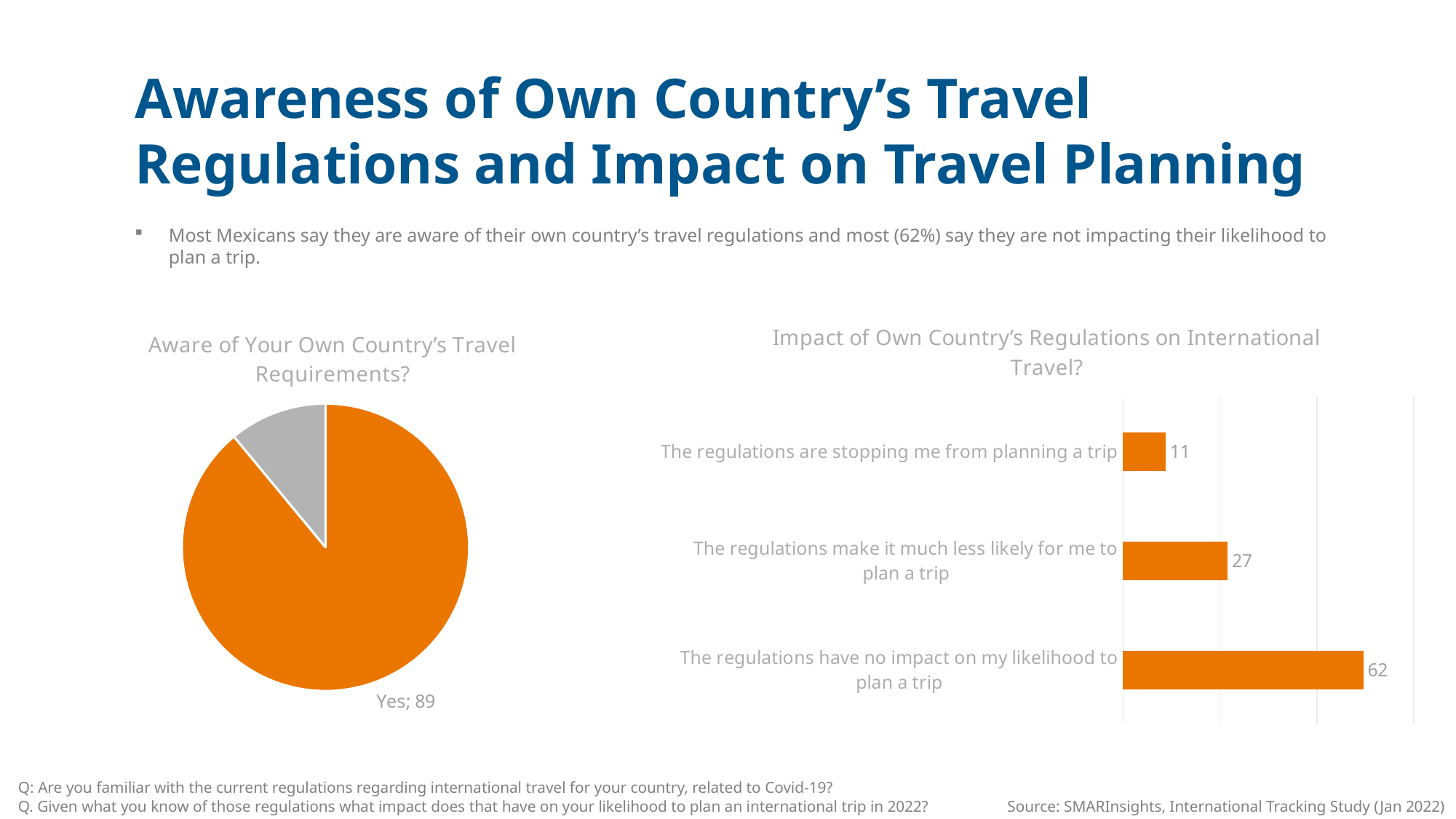
What kind of chart is 'Impact of Own Country's Regulations on International Travel?' bar chart In the bar chart 'Impact of Own Country's Regulations on International Travel?', what is the value for 'The regulations make it much less likely for me to plan a trip'? 27 In the bar chart on the right, what is the difference between 'The regulations have no impact on my likelihood to plan a trip' and 'The regulations make it much less likely for me to plan a trip'? 35 What kind of chart is 'Aware of Your Own Country's Travel Requirements?' pie chart In the pie chart 'Aware of Your Own Country's Travel Requirements?', what value is shown for the 'Yes' slice? 89 In the bar chart on the right, which category has the highest value? The regulations have no impact on my likelihood to plan a trip In the bar chart 'Impact of Own Country's Regulations on International Travel?', what is the value for 'The regulations have no impact on my likelihood to plan a trip'? 62 In the bar chart 'Impact of Own Country's Regulations on International Travel?', what is the value for 'The regulations are stopping me from planning a trip'? 11 In the pie chart on the left, which slice is larger, the orange 'Yes' slice or the grey slice? Yes In the bar chart on the right, what is the difference between 'The regulations make it much less likely for me to plan a trip' and 'The regulations are stopping me from planning a trip'? 16 In the bar chart on the right, which category has the lowest value? The regulations are stopping me from planning a trip How many categories are shown in the bar chart 'Impact of Own Country's Regulations on International Travel?' 3